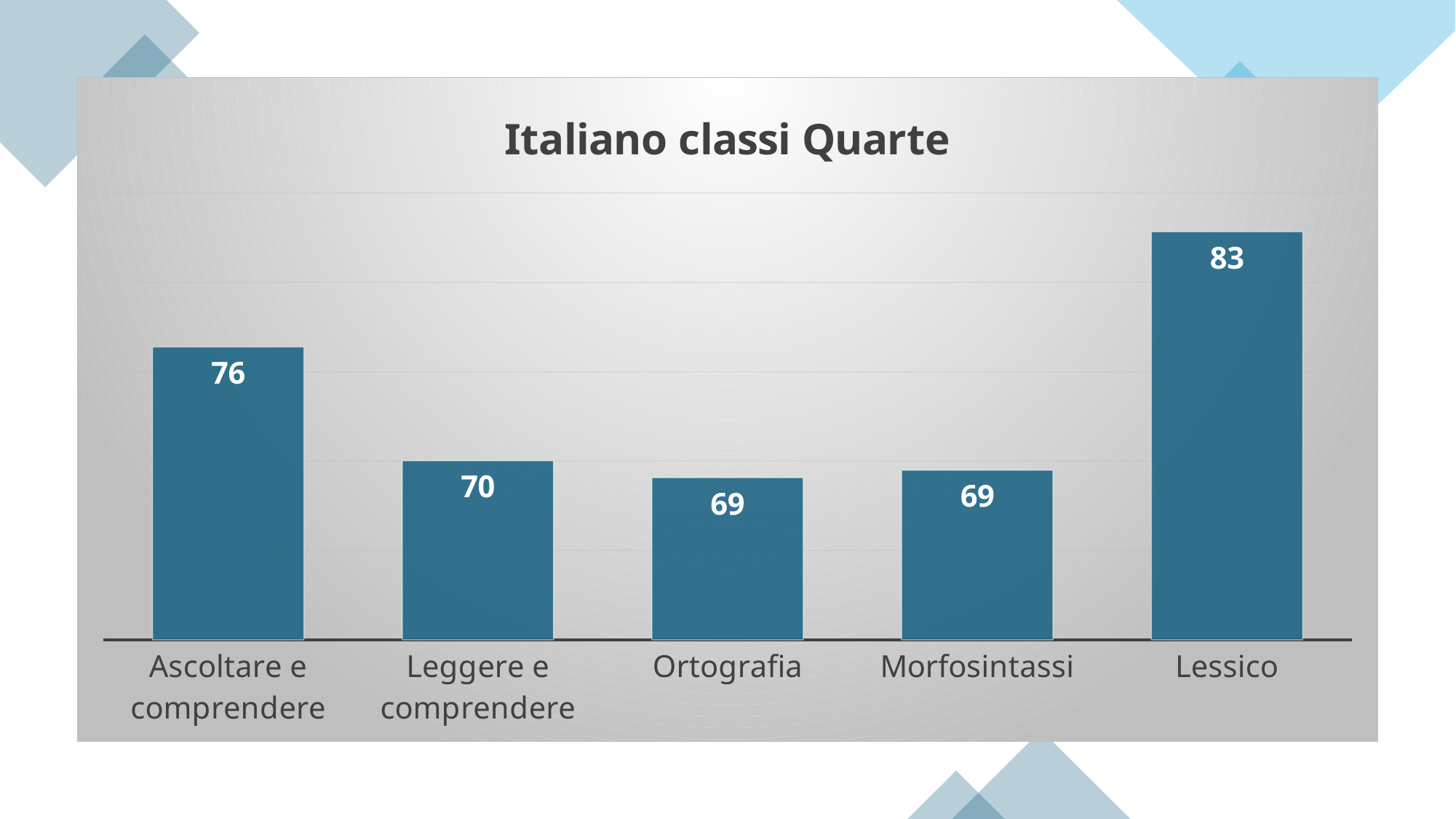
What is the difference between the values for Lessico and Ascoltare e comprendere? 7 Which category has the highest value? Lessico What kind of chart is shown on the slide? Bar chart How many categories are shown in the chart? 5 Which is larger, the value for Ascoltare e comprendere or the value for Morfosintassi? Ascoltare e comprendere What is the title of the chart? Italiano classi Quarte What is the value for Ortografia? 69 What is the difference between the values for Ascoltare e comprendere and Leggere e comprendere? 6 Which two categories share the same value of 69? Ortografia and Morfosintassi What is the value for Ascoltare e comprendere? 76 What is the value for Lessico? 83 What is the value for Leggere e comprendere? 70